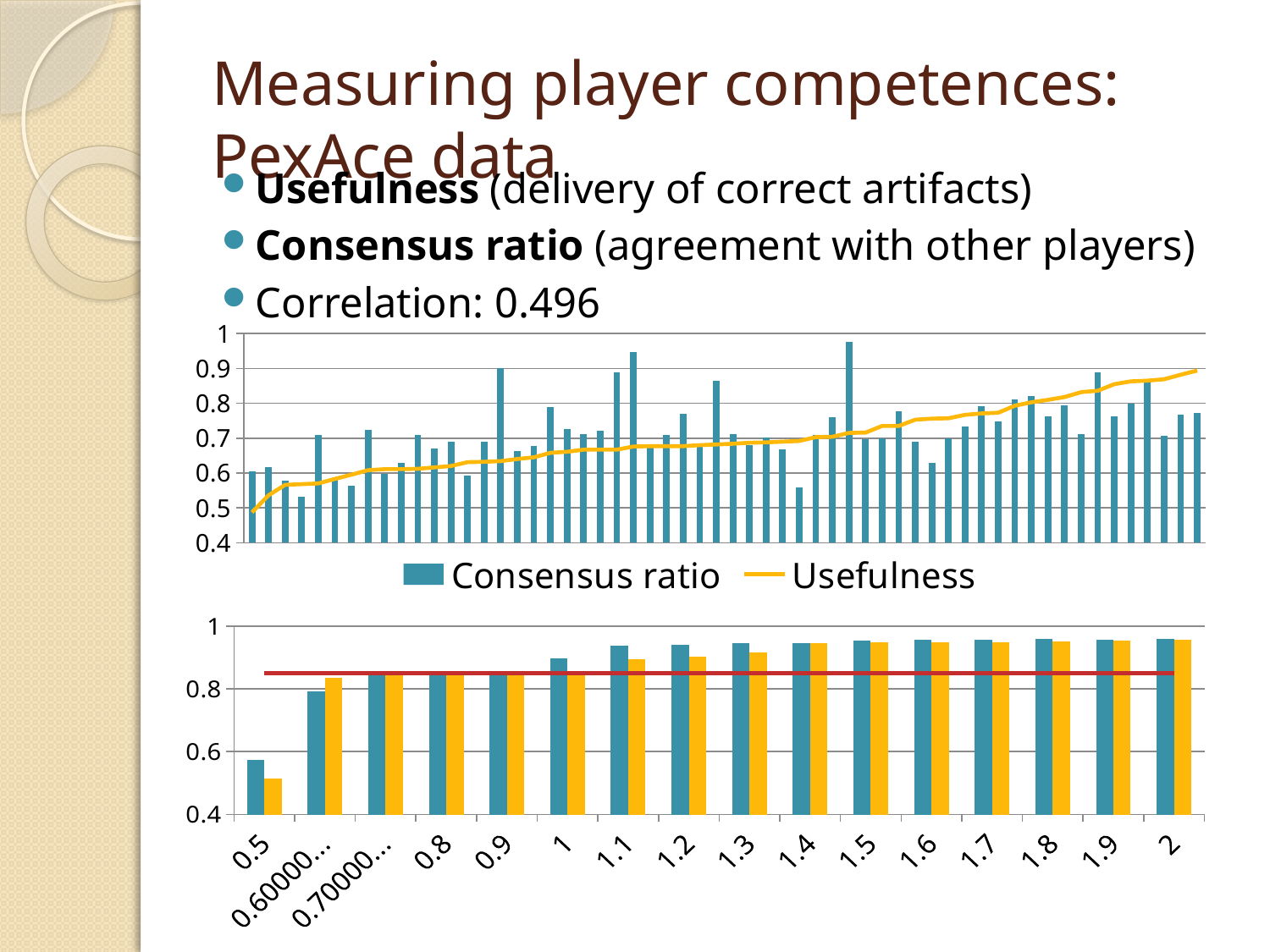
In the bottom chart, for category 0.5, which bar is taller, the teal bar or the yellow bar? teal bar In the top chart, is the value at the right end of the Usefulness line greater or less than 0.8? greater In the top chart, does the Usefulness line rise or fall from left to right? rise In the bottom chart, is the teal bar for category 2 greater or less than 0.9? greater How many series does the legend of the top chart list? 2 How many categories are shown on the x axis of the bottom chart? 16 In the bottom chart, is the yellow bar for category 0.5 greater or less than 0.6? less What are the two series named in the legend of the top chart? Consensus ratio and Usefulness In the top chart, which series is drawn as a line rather than bars? Usefulness In the bottom chart, which category has the lowest teal bar? 0.5 What kind of chart is the bottom chart on the slide? combination bar and line chart